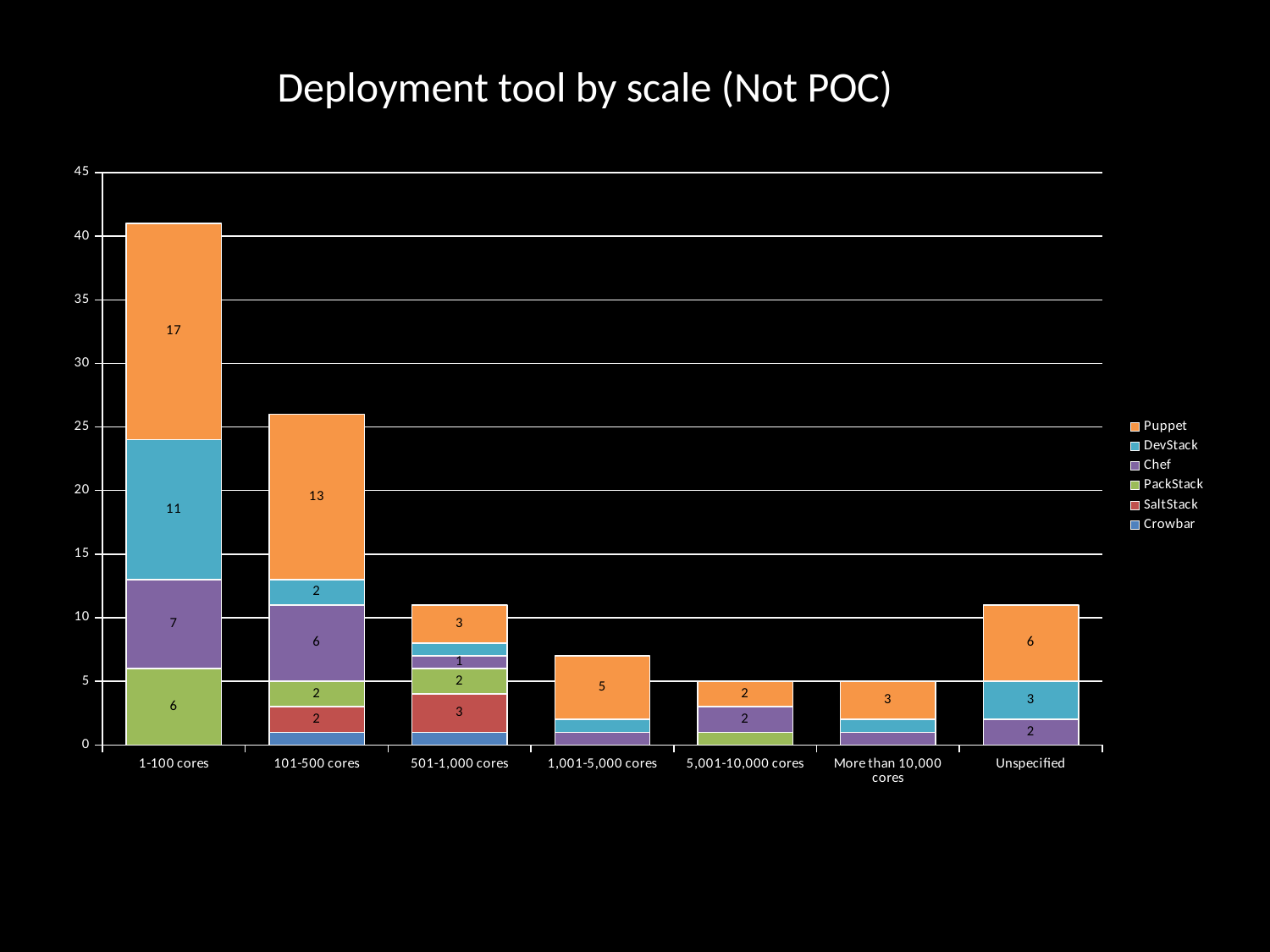
What is the total of the stacked bar for 1-100 cores? 41 What is the difference between the Puppet value for 1-100 cores and the Puppet value for 101-500 cores? 4 What is the Puppet value for the 1-100 cores category? 17 How many scale categories are shown on the x axis? 7 What is the DevStack value for the 1-100 cores category? 11 How many series does the legend list? 6 What type of chart is shown on the slide? Stacked bar chart Which category has the larger Puppet value, 1-100 cores or 101-500 cores? 1-100 cores Is the total height of the stacked bar for 1,001-5,000 cores greater or less than 10? less What is the Chef value for the 101-500 cores category? 6 Which category has the tallest stacked bar? 1-100 cores What is the SaltStack value for the 501-1,000 cores category? 3